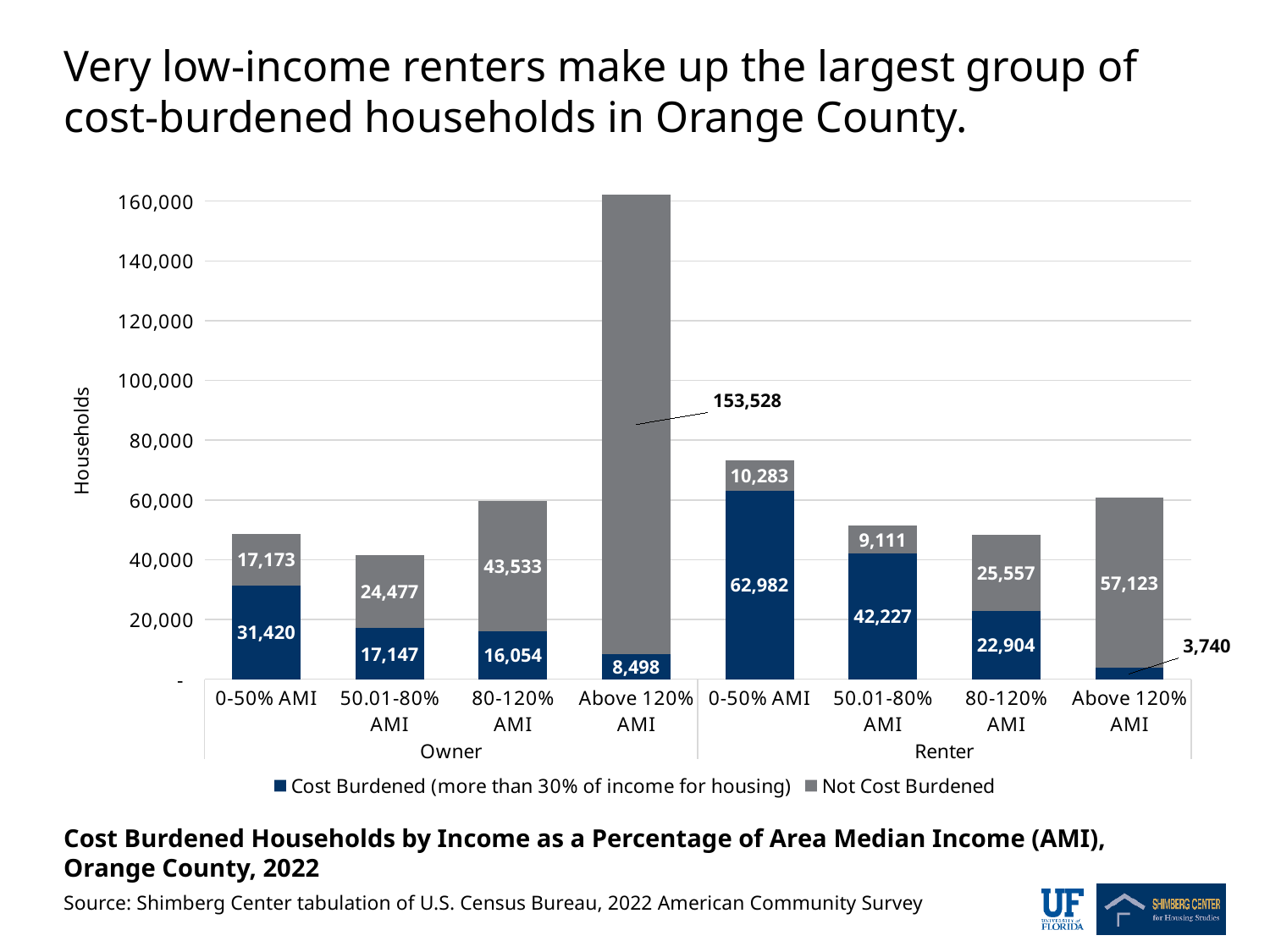
Which income group has the highest number of cost-burdened households? Renter 0-50% AMI What is the difference between cost-burdened renter households and cost-burdened owner households in the 0-50% AMI group? 31,562 What kind of chart is shown on the slide? Stacked bar chart What is the number of cost-burdened renter households in the 0-50% AMI group? 62,982 How many series does the legend list? 2 What is the number of not cost-burdened owner households in the Above 120% AMI group? 153,528 What is the total number of renter households in the 0-50% AMI group (cost burdened plus not cost burdened)? 73,265 Which is larger: the number of cost-burdened owner households at 50.01-80% AMI or the number of not cost-burdened owner households at 50.01-80% AMI? Not Cost Burdened (24,477) Which income group has the lowest number of cost-burdened households? Renter Above 120% AMI Is the total height of the Owner Above 120% AMI bar greater or less than 140,000? greater How many income-group bars are plotted in total across Owner and Renter? 8 What is the number of cost-burdened renter households in the Above 120% AMI group? 3,740